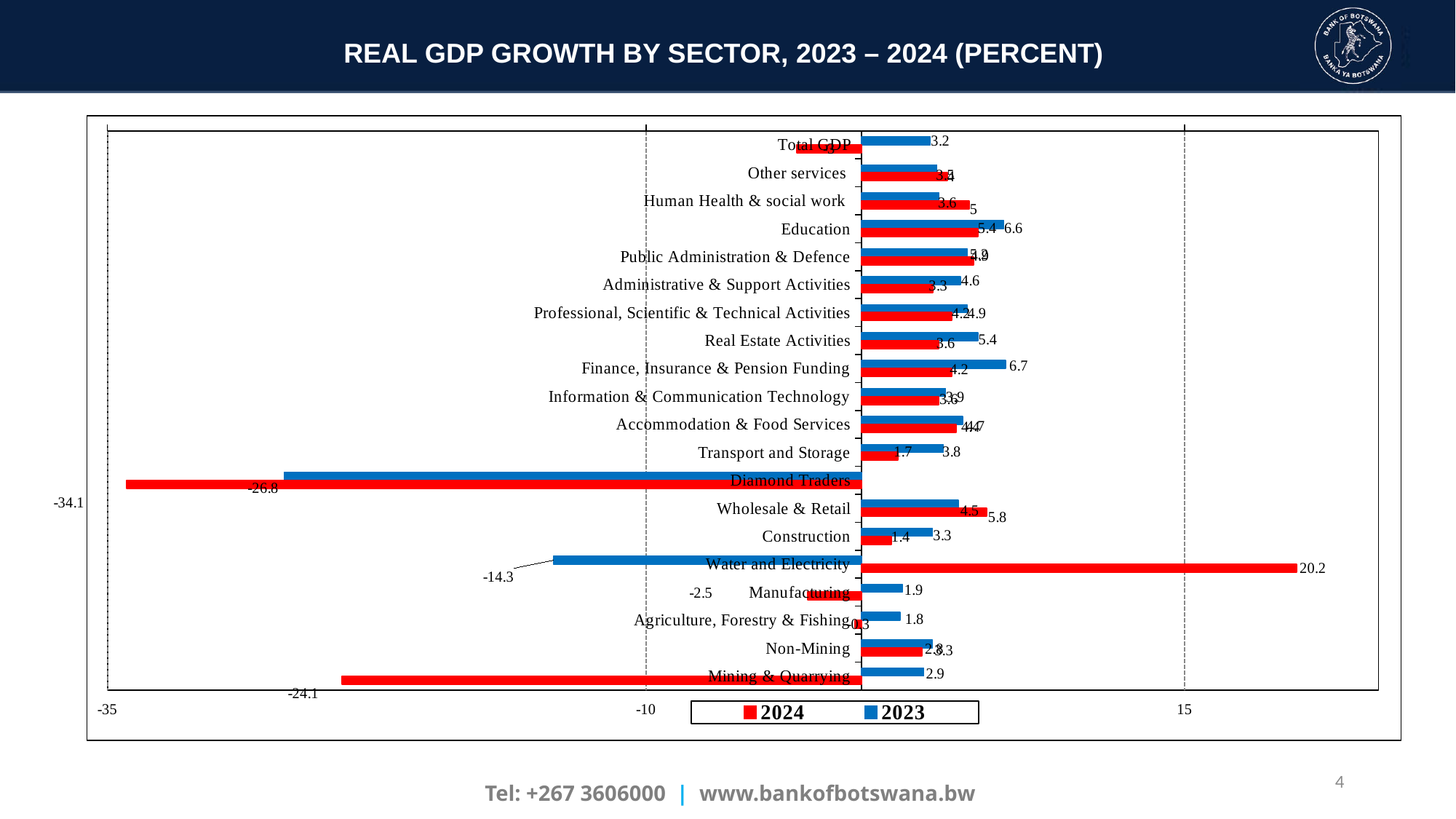
What is the 2024 value for Manufacturing? -2.5 How many sector categories are shown on the chart? 20 For Wholesale & Retail, which year has the larger value, 2023 or 2024? 2024 How many series does the legend list? 2 What kind of chart is shown on the slide? bar chart What is the 2024 value for Water and Electricity? 20.2 What is the 2024 value for Mining & Quarrying? -24.1 Which sector has the highest 2024 value? Water and Electricity What is the 2023 value for Finance, Insurance & Pension Funding? 6.7 What is the 2023 value for Diamond Traders? -26.8 What is the difference between the 2023 and 2024 values for Education? 1.2 Which sector has the lowest 2023 value? Diamond Traders